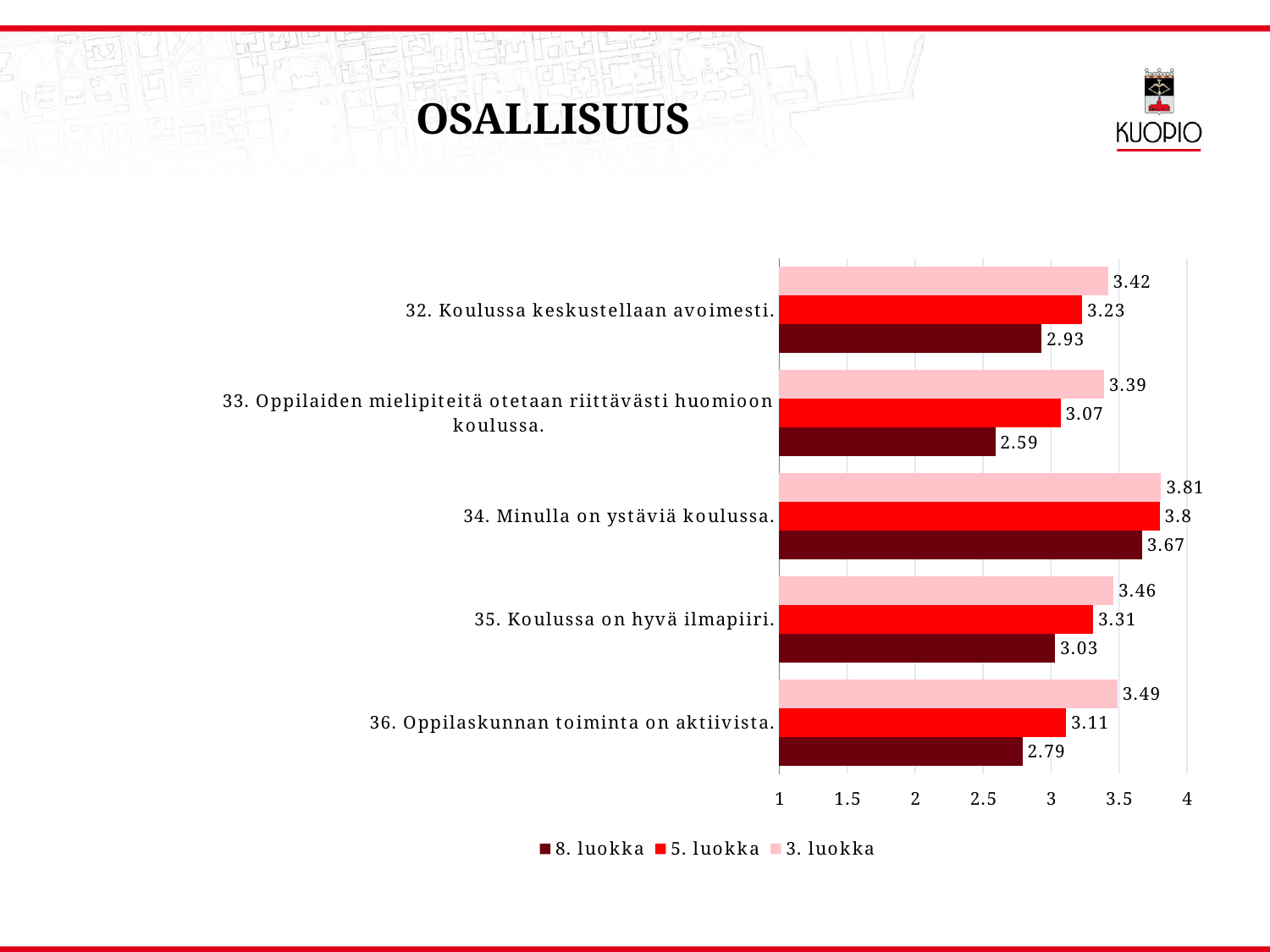
What is the difference between the 3. luokka and 8. luokka values for "32. Koulussa keskustellaan avoimesti."? 0.49 Which category has the lowest value for 3. luokka? 33. Oppilaiden mielipiteitä otetaan riittävästi huomioon koulussa. What is the value for 3. luokka on "34. Minulla on ystäviä koulussa."? 3.81 What is the value for 5. luokka on "36. Oppilaskunnan toiminta on aktiivista."? 3.11 What is the title of the slide containing the chart? OSALLISUUS What is the value for 8. luokka on "33. Oppilaiden mielipiteitä otetaan riittävästi huomioon koulussa."? 2.59 How many categories (statements) are shown on the chart? 5 Is the 8. luokka value for "36. Oppilaskunnan toiminta on aktiivista." greater or less than 3? less What kind of chart is shown on the slide? bar chart How many series does the legend list? 3 Which is larger for "35. Koulussa on hyvä ilmapiiri.": the 5. luokka value or the 8. luokka value? 5. luokka Which category has the highest value for 8. luokka? 34. Minulla on ystäviä koulussa.